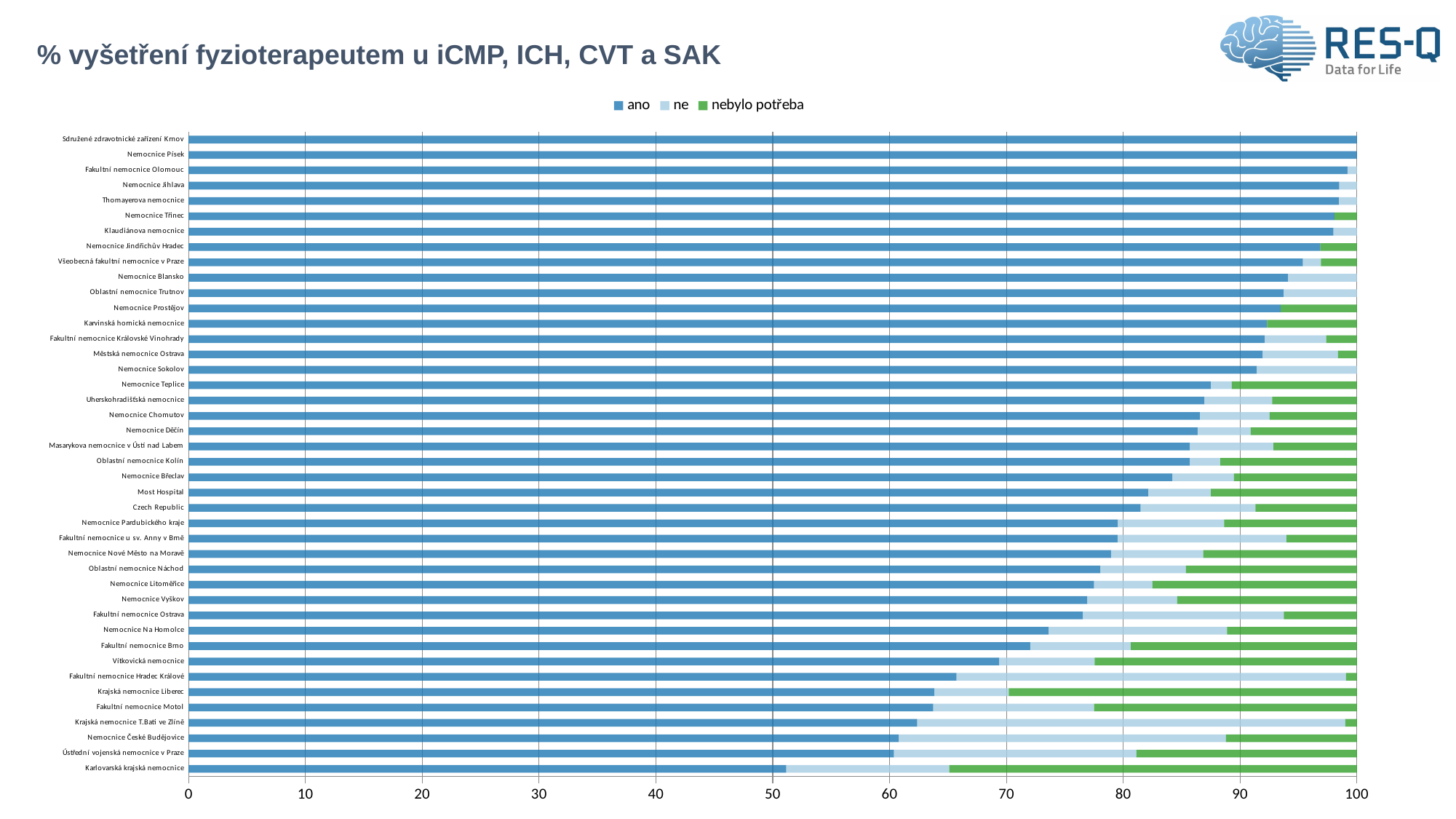
What kind of chart is shown on the slide? bar chart How many series does the legend list? 3 Going from the top bar to the bottom bar, do the 'ano' values increase or decrease? decrease Is the 'ano' value for Karlovarská krajská nemocnice greater or less than 60? less Is the 'ano' value for Nemocnice Teplice greater or less than 80? greater Which has the larger 'ano' share, Nemocnice Písek or Fakultní nemocnice Brno? Nemocnice Písek Which hospital has the lowest 'ano' share? Karlovarská krajská nemocnice What are the three series named in the legend? ano, ne, nebylo potřeba Is the 'ano' value for Czech Republic greater or less than 70? greater What is the title of the chart? % vyšetření fyzioterapeutem u iCMP, ICH, CVT a SAK